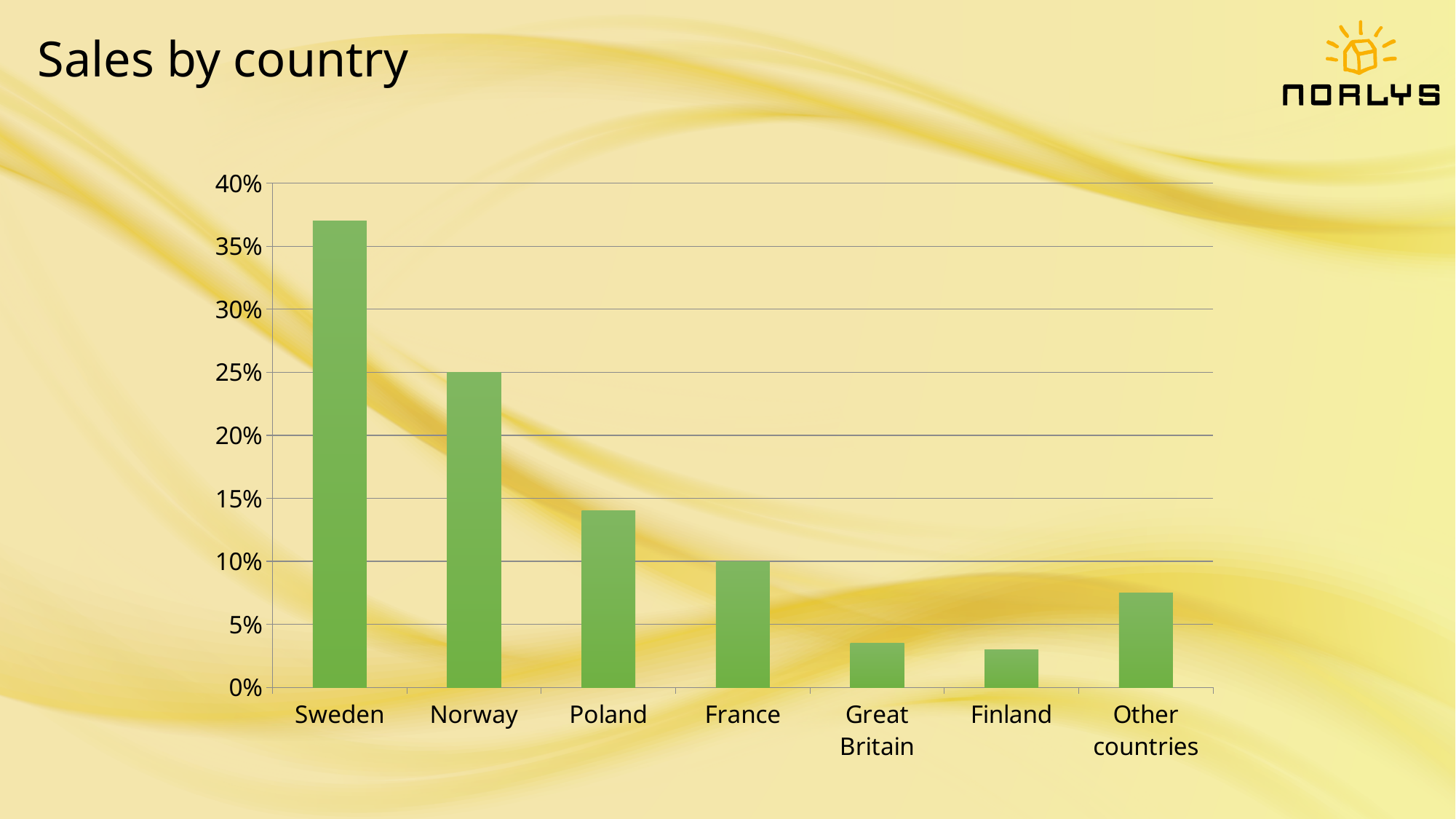
Is the value for Finland greater or less than 5%? less Which country has the highest sales share? Sweden Is the value for Poland greater or less than 15%? less Is the value for Other countries greater or less than 5%? greater What colour are the bars in the chart? green What type of chart is shown on the slide? bar chart What is the sales share for Norway? 25% What is the title of the chart? Sales by country How many countries/categories are shown on the x axis? 7 Which has a larger sales share, Poland or France? Poland What is the sales share for France? 10%